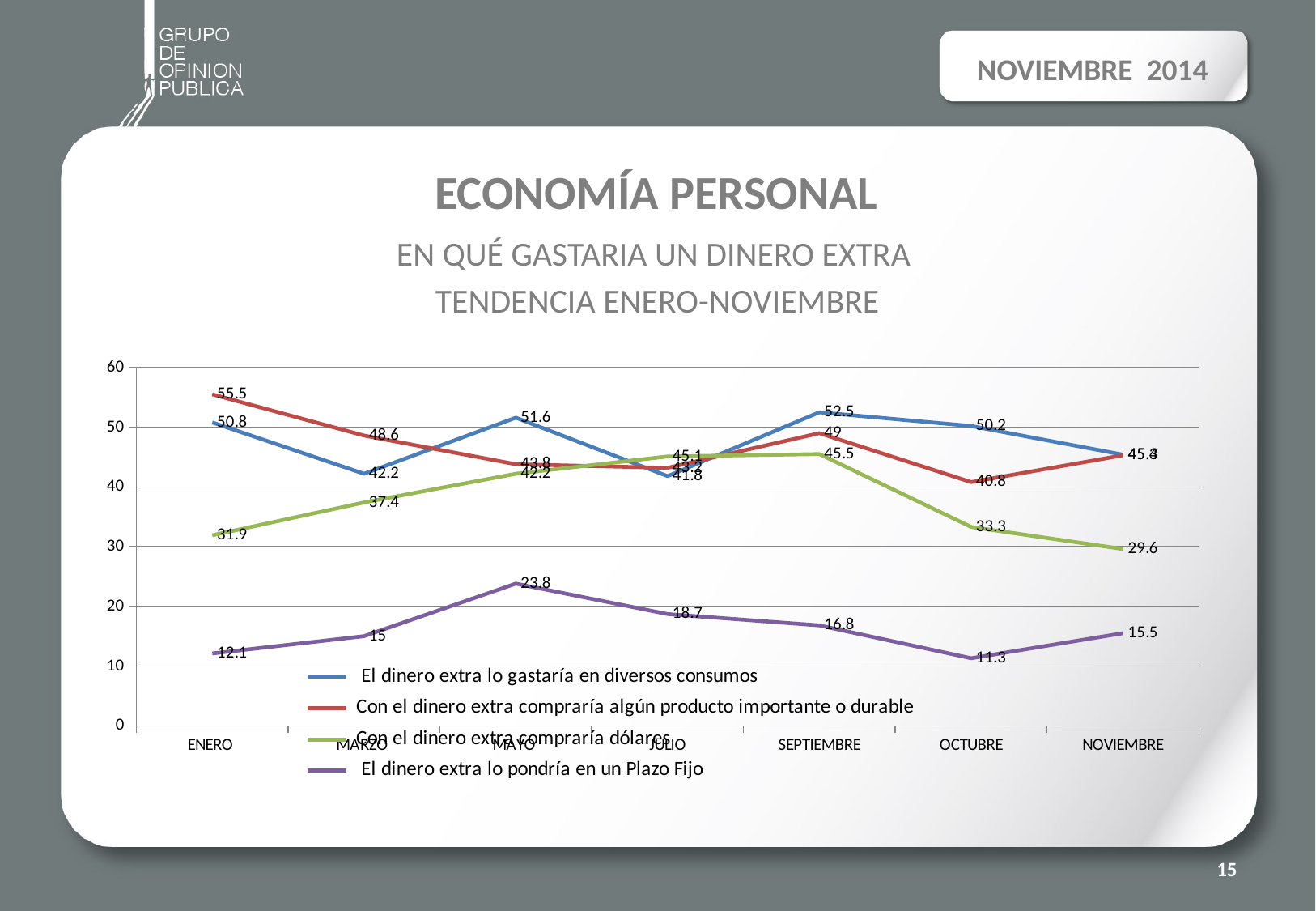
What is the value for 'Con el dinero extra compraría dólares' in OCTUBRE? 33.3 What is the value for 'El dinero extra lo pondría en un Plazo Fijo' in MAYO? 23.8 What is the value for 'El dinero extra lo gastaría en diversos consumos' in SEPTIEMBRE? 52.5 In which month is 'El dinero extra lo pondría en un Plazo Fijo' lowest? OCTUBRE What is the value for 'Con el dinero extra compraría algún producto importante o durable' in ENERO? 55.5 Does 'Con el dinero extra compraría dólares' rise or fall from ENERO to SEPTIEMBRE? Rise How many months are shown on the x axis? 7 How many series does the legend list? 4 In which month is 'Con el dinero extra compraría dólares' highest? SEPTIEMBRE What is the difference between the SEPTIEMBRE and NOVIEMBRE values for 'Con el dinero extra compraría dólares'? 15.9 What type of chart is shown on the slide? Line chart In ENERO, which is larger: 'El dinero extra lo gastaría en diversos consumos' or 'Con el dinero extra compraría algún producto importante o durable'? Con el dinero extra compraría algún producto importante o durable